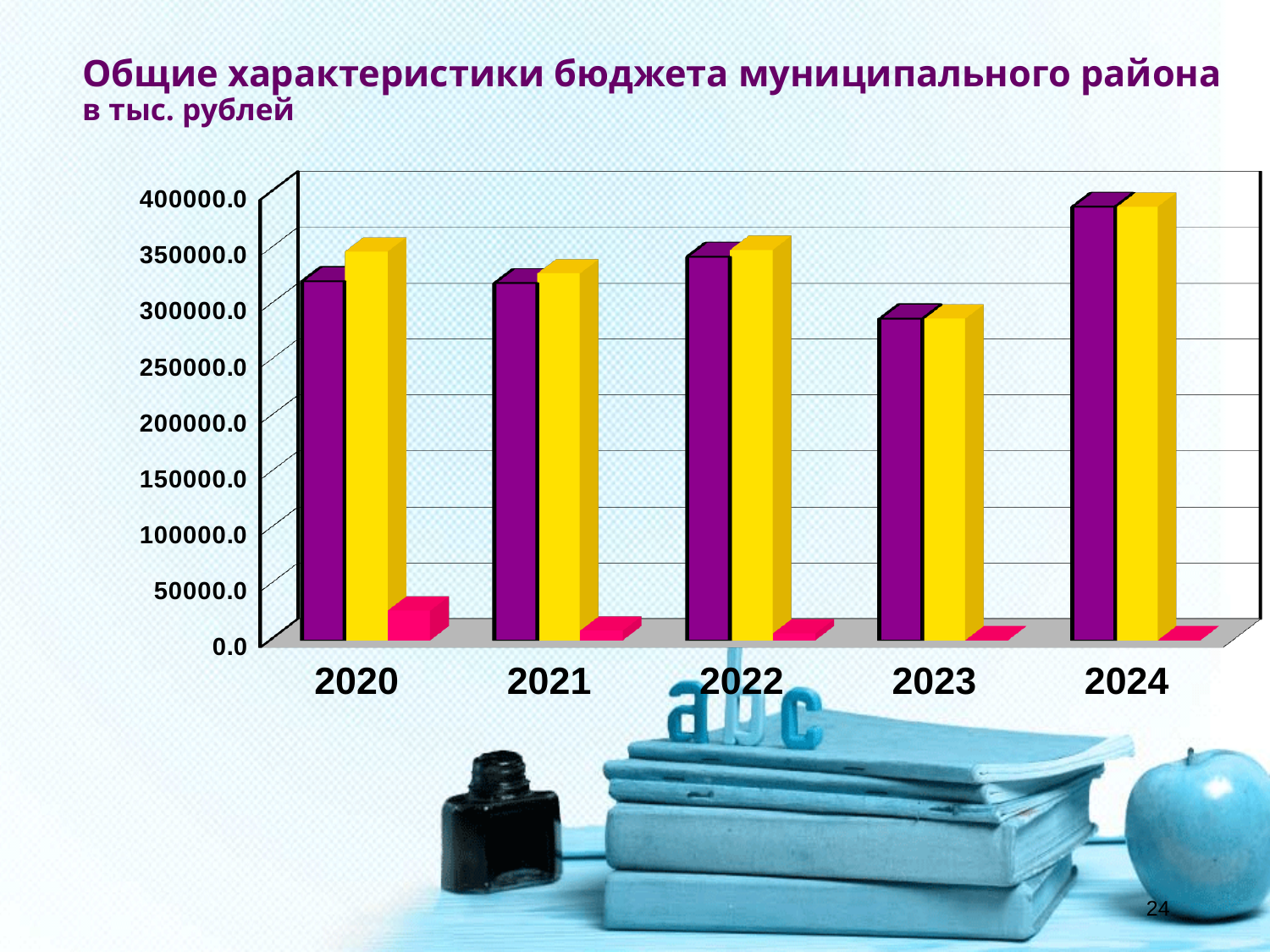
In which year is the purple bar the tallest? 2024 In which year is the yellow bar the tallest? 2024 How many bars are plotted for each year in the chart? 3 In which year is the purple bar the shortest? 2023 Is the value of the purple bar for 2020 greater or less than 350000.0? less What kind of chart is shown on the slide? bar chart Is the value of the yellow bar for 2024 greater or less than 350000.0? greater How many years are shown on the x axis of the chart? 5 In which year is the pink bar the tallest? 2020 Which is larger: the purple bar for 2020 or the purple bar for 2023? 2020 In which year is the yellow bar the shortest? 2023 Is the value of the pink bar for 2020 greater or less than 50000.0? less